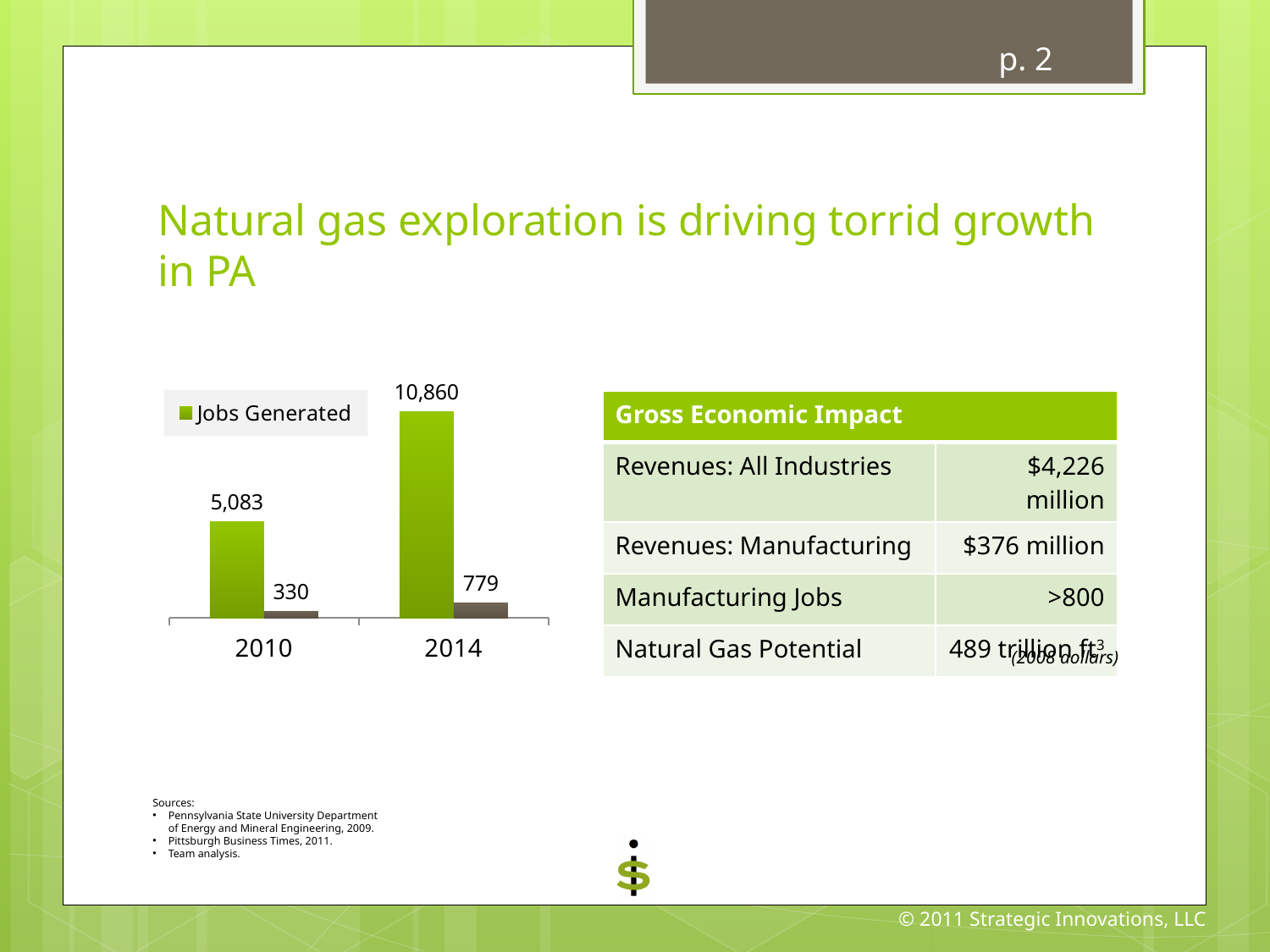
What is the value of Jobs Generated for 2010? 5,083 Do the Jobs Generated values rise or fall from 2010 to 2014? rise Which year has the lower value for Jobs Generated? 2010 What is the value shown on the smaller brown bar for 2014? 779 What type of chart is shown on the slide? bar chart How many years are shown on the x axis of the chart? 2 What is the difference between the smaller brown bar values for 2014 and 2010? 449 What is the value shown on the smaller brown bar for 2010? 330 What is the value of Jobs Generated for 2014? 10,860 What is the difference in Jobs Generated between 2014 and 2010? 5,777 Which year has the higher value for Jobs Generated? 2014 How many series does the chart legend list? 1